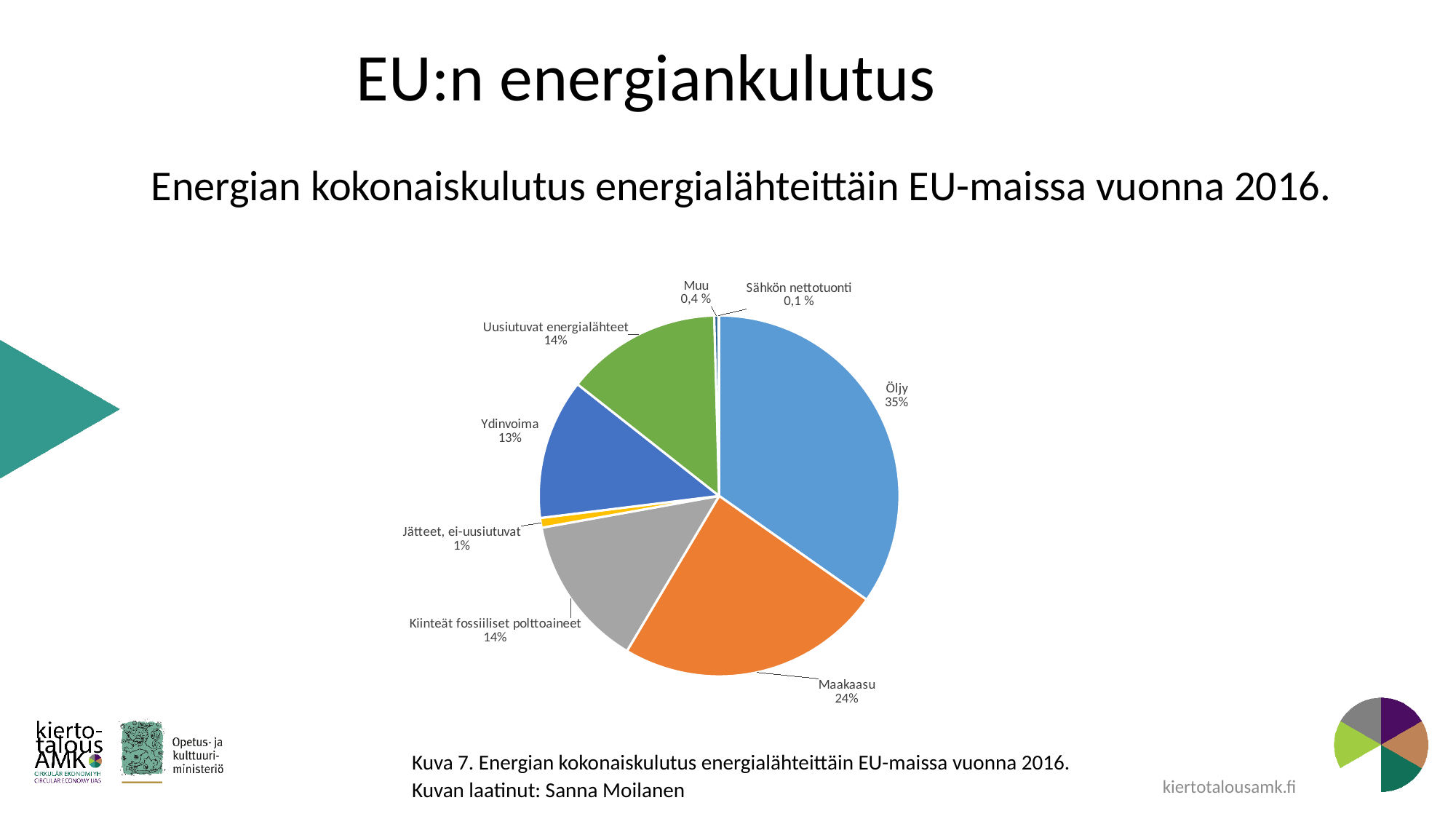
Which category has the smallest slice of the pie? Sähkön nettotuonti What share of the pie does Muu have? 0,4 % Which is larger, Ydinvoima or Uusiutuvat energialähteet? Uusiutuvat energialähteet What share of the pie does Öljy have? 35% What colour is the Maakaasu slice? Orange How many slices does the pie chart have? 8 What is the difference in percentage points between Öljy and Maakaasu? 11 Which category has the largest slice of the pie? Öljy What kind of chart is shown on the slide? Pie chart What share of the pie does Sähkön nettotuonti have? 0,1 % What share of the pie does Maakaasu have? 24% What share of the pie does Ydinvoima have? 13%